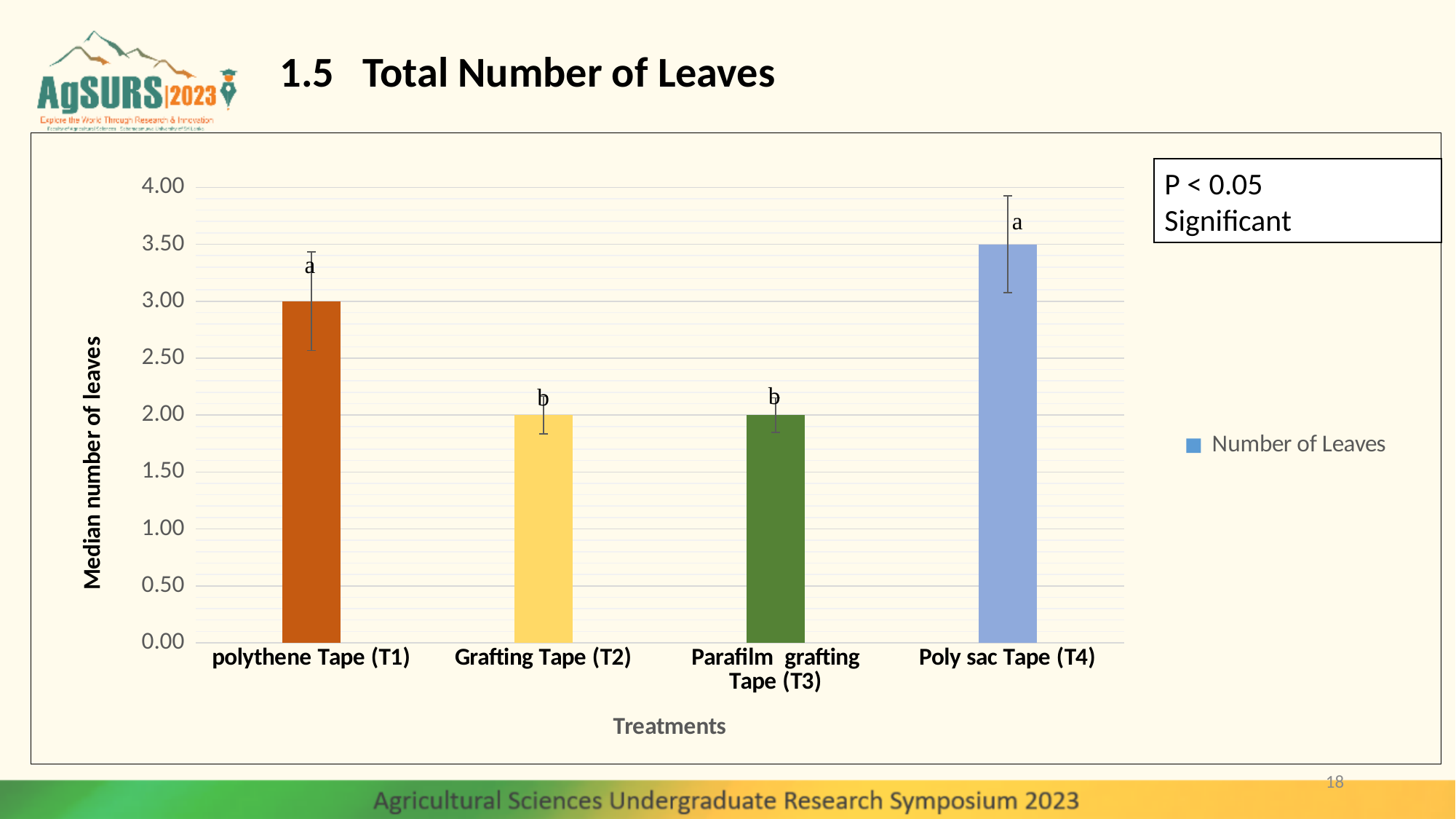
What is the median number of leaves for polythene Tape (T1)? 3.00 Which treatment has a higher median number of leaves, polythene Tape (T1) or Parafilm grafting Tape (T3)? polythene Tape (T1) What is the median number of leaves for Poly sac Tape (T4)? 3.50 What is the label of the y axis of the chart? Median number of leaves Is the value for Poly sac Tape (T4) greater or less than 3.00? greater How many series does the chart legend list? 1 Which treatment has the highest median number of leaves? Poly sac Tape (T4) What is the difference in median number of leaves between Poly sac Tape (T4) and Grafting Tape (T2)? 1.50 What type of chart is shown on the slide? bar chart How many treatments are shown on the x axis of the chart? 4 What is the median number of leaves for Grafting Tape (T2)? 2.00 What is the name of the series listed in the chart legend? Number of Leaves